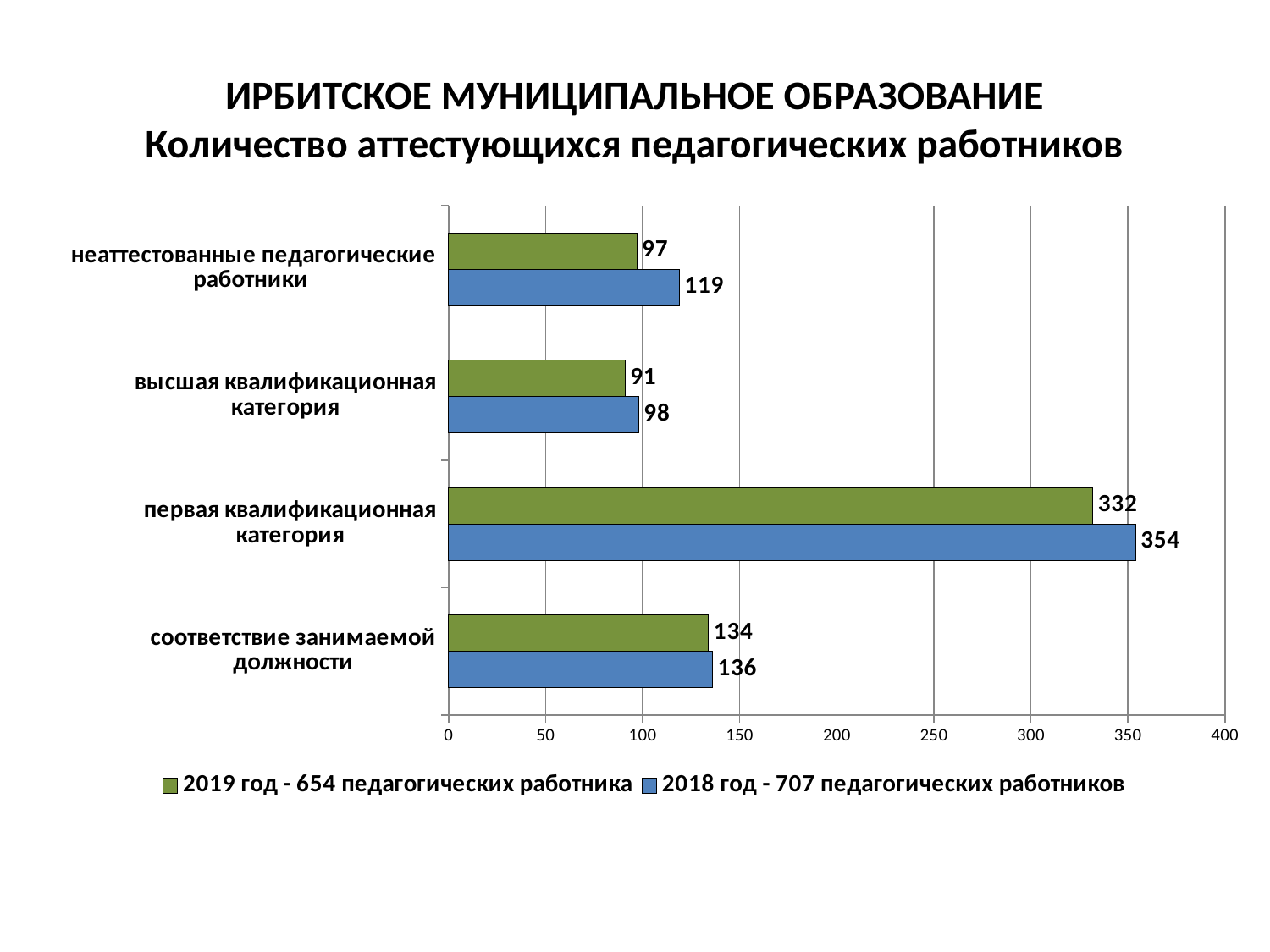
What is the 2018 value for 'неаттестованные педагогические работники'? 119 What is the 2018 value for 'соответствие занимаемой должности'? 136 What is the difference between the 2018 and 2019 values for 'неаттестованные педагогические работники'? 22 How many series does the legend list? 2 What is the difference between the 2018 and 2019 values for 'первая квалификационная категория'? 22 Which category has the lowest 2019 value? высшая квалификационная категория What kind of chart is shown on the slide? bar chart How many categories are shown on the chart? 4 Which is larger for 'неаттестованные педагогические работники': the 2019 value or the 2018 value? 2018 value Which category has the highest 2018 value? первая квалификационная категория What is the 2019 value for 'первая квалификационная категория'? 332 What is the 2019 value for 'высшая квалификационная категория'? 91